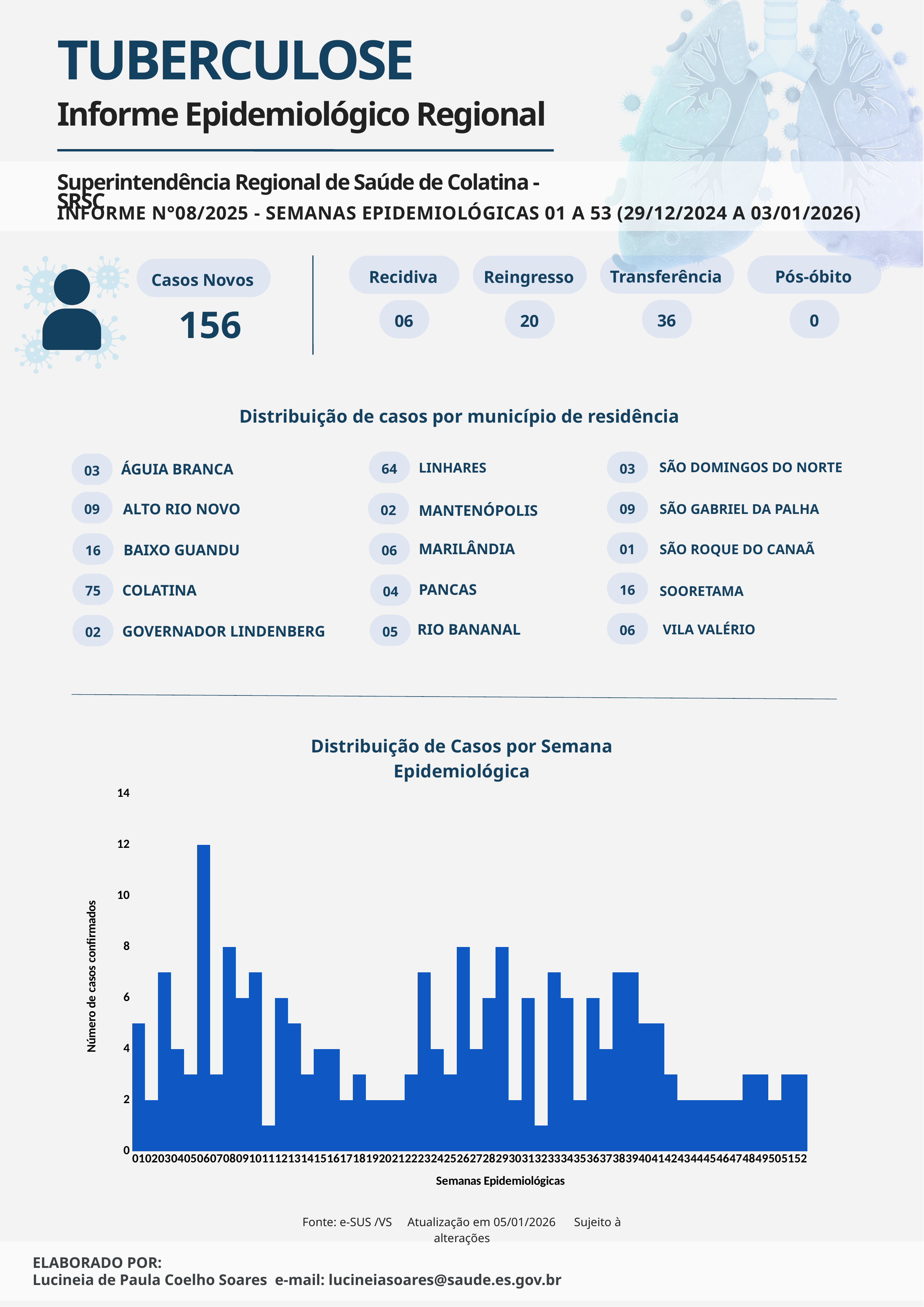
What is the label of the vertical axis in the chart 'Distribuição de Casos por Semana Epidemiológica'? Número de casos confirmados What is the label of the horizontal axis in the chart 'Distribuição de Casos por Semana Epidemiológica'? Semanas Epidemiológicas In the chart 'Distribuição de Casos por Semana Epidemiológica', how many confirmed cases are shown for week 06? 12 What kind of chart is 'Distribuição de Casos por Semana Epidemiológica'? bar chart In the chart 'Distribuição de Casos por Semana Epidemiológica', is the value for week 06 greater or less than 10? greater In the chart 'Distribuição de Casos por Semana Epidemiológica', is the value for week 11 greater or less than 2? less In the chart 'Distribuição de Casos por Semana Epidemiológica', how many confirmed cases are shown for week 08? 8 In the chart 'Distribuição de Casos por Semana Epidemiológica', which epidemiological week has the highest number of confirmed cases? 06 In the chart 'Distribuição de Casos por Semana Epidemiológica', what is the difference in confirmed cases between week 06 and week 08? 4 In the chart 'Distribuição de Casos por Semana Epidemiológica', is the value for week 01 greater or less than 4? greater In the chart 'Distribuição de Casos por Semana Epidemiológica', which has more confirmed cases, week 06 or week 08? week 06